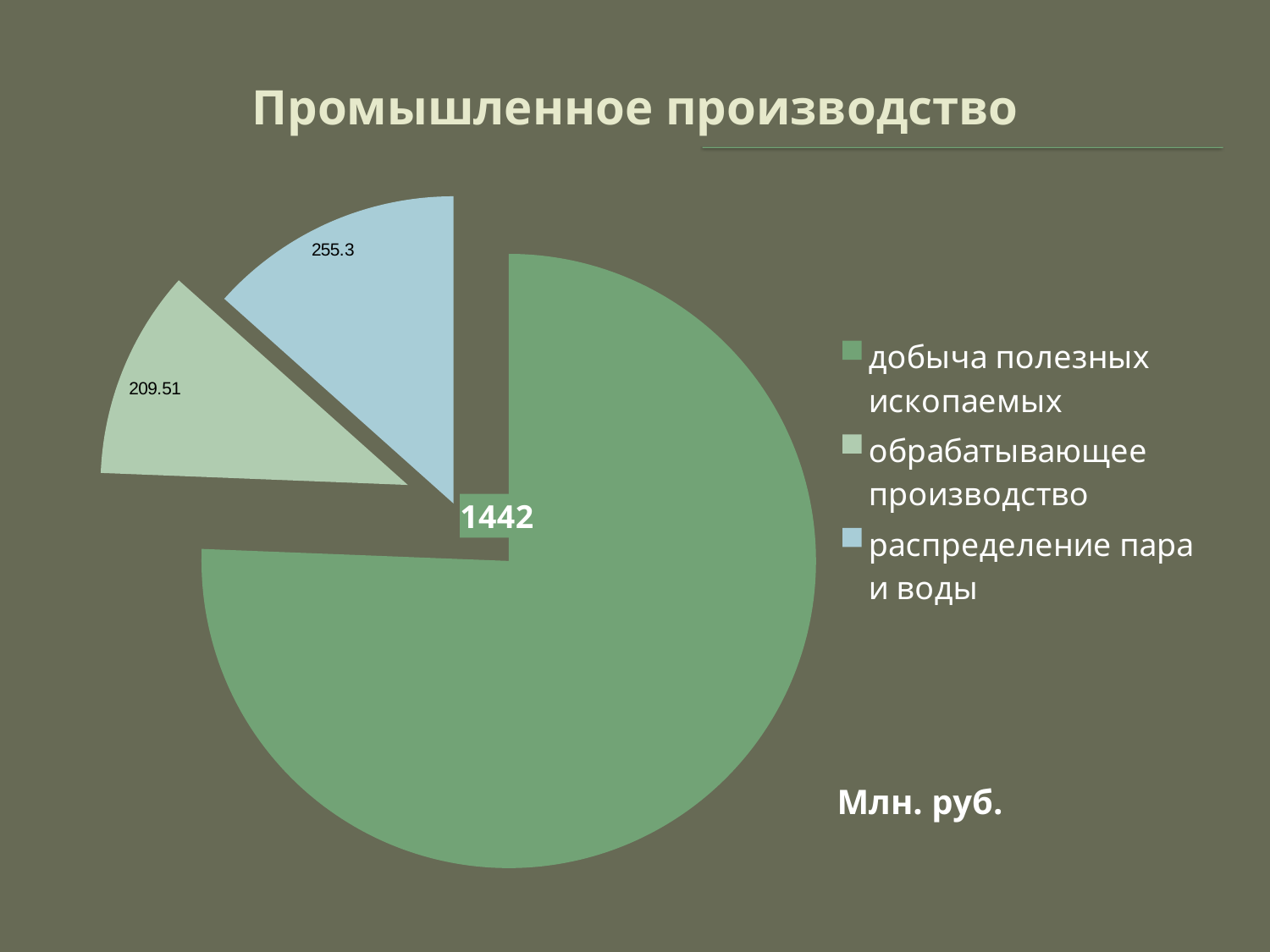
How many slices does the pie chart have? 3 What is the title of the chart? Промышленное производство What kind of chart is shown on the slide? pie chart Which category has the smallest slice of the pie? обрабатывающее производство What is the difference between the values for распределение пара и воды and обрабатывающее производство? 45.79 Which is larger, the value for распределение пара и воды or the value for обрабатывающее производство? распределение пара и воды What is the value for обрабатывающее производство? 209.51 What is the difference between the values for добыча полезных ископаемых and распределение пара и воды? 1186.7 What is the value for добыча полезных ископаемых? 1442 What unit is stated for the values on the chart? Млн. руб. Which category has the largest slice of the pie? добыча полезных ископаемых What is the value for распределение пара и воды? 255.3